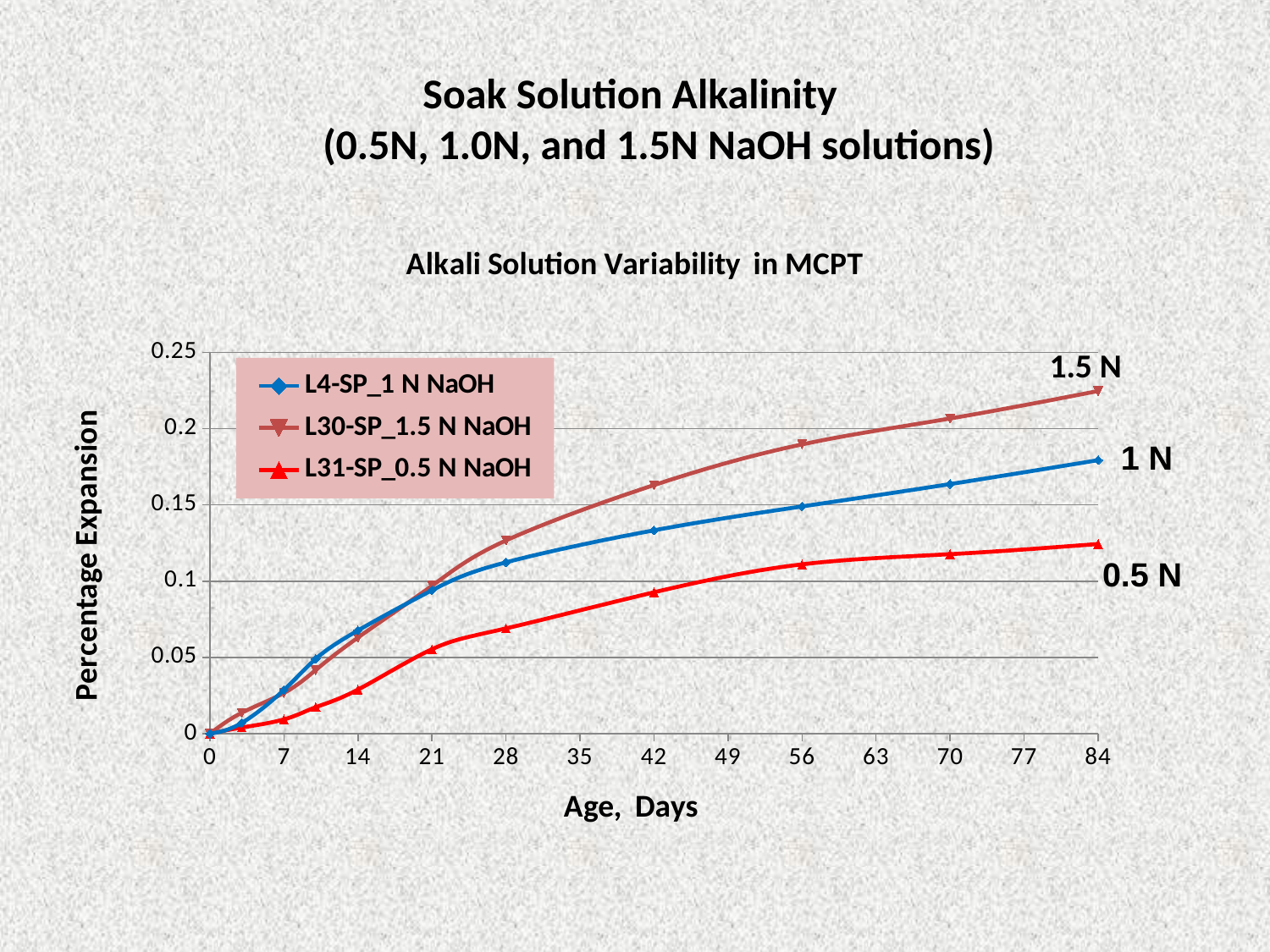
Is the value for L31-SP_0.5 N NaOH at 84 days greater or less than 0.1? greater Is the value for L30-SP_1.5 N NaOH at 84 days greater or less than 0.2? greater What kind of chart is shown on the slide? Line chart Is the value for L4-SP_1 N NaOH at 84 days greater or less than 0.2? less What is the title of the chart? Alkali Solution Variability in MCPT What is the label of the x axis? Age, Days Do the percentage expansion values rise or fall as age increases? Rise Which series has the highest percentage expansion at 84 days? L30-SP_1.5 N NaOH At 42 days, which series has the larger value: L4-SP_1 N NaOH or L31-SP_0.5 N NaOH? L4-SP_1 N NaOH How many series does the legend list? 3 Which series has the lowest percentage expansion at 84 days? L31-SP_0.5 N NaOH